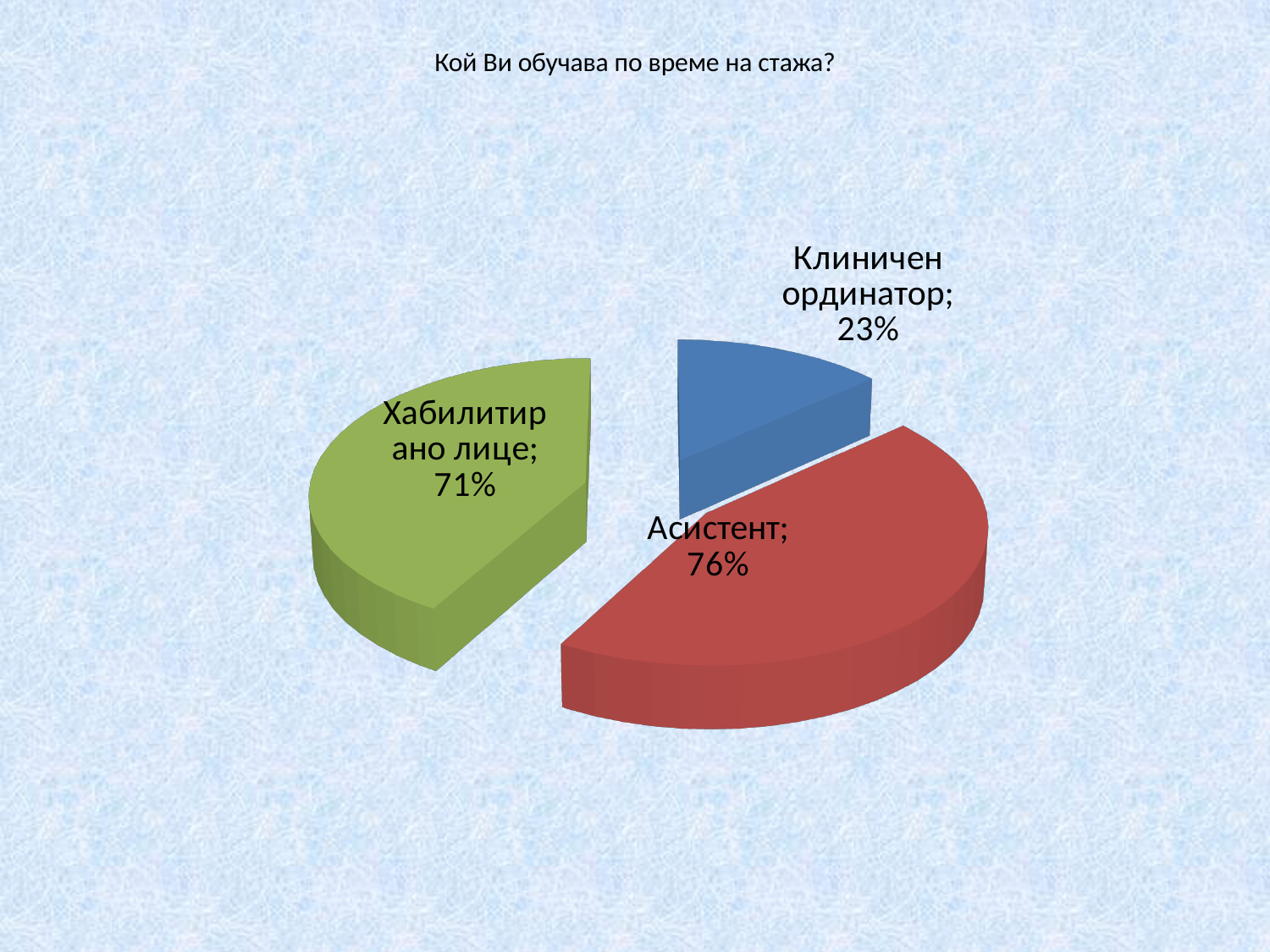
What is the difference between the percentages for Асистент and Хабилитирано лице? 5% Which is larger, the percentage for Хабилитирано лице or for Клиничен ординатор? Хабилитирано лице Which category has the lowest percentage? Клиничен ординатор What kind of chart is shown on the slide? Pie chart What percentage is shown for Клиничен ординатор? 23% What percentage is shown for Хабилитирано лице? 71% What percentage is shown for Асистент? 76% What is the title of the chart? Кой Ви обучава по време на стажа? Which category has the highest percentage? Асистент What colour is the slice for Асистент? Red What is the difference between the percentages for Асистент and Клиничен ординатор? 53% How many categories are shown in the chart? 3